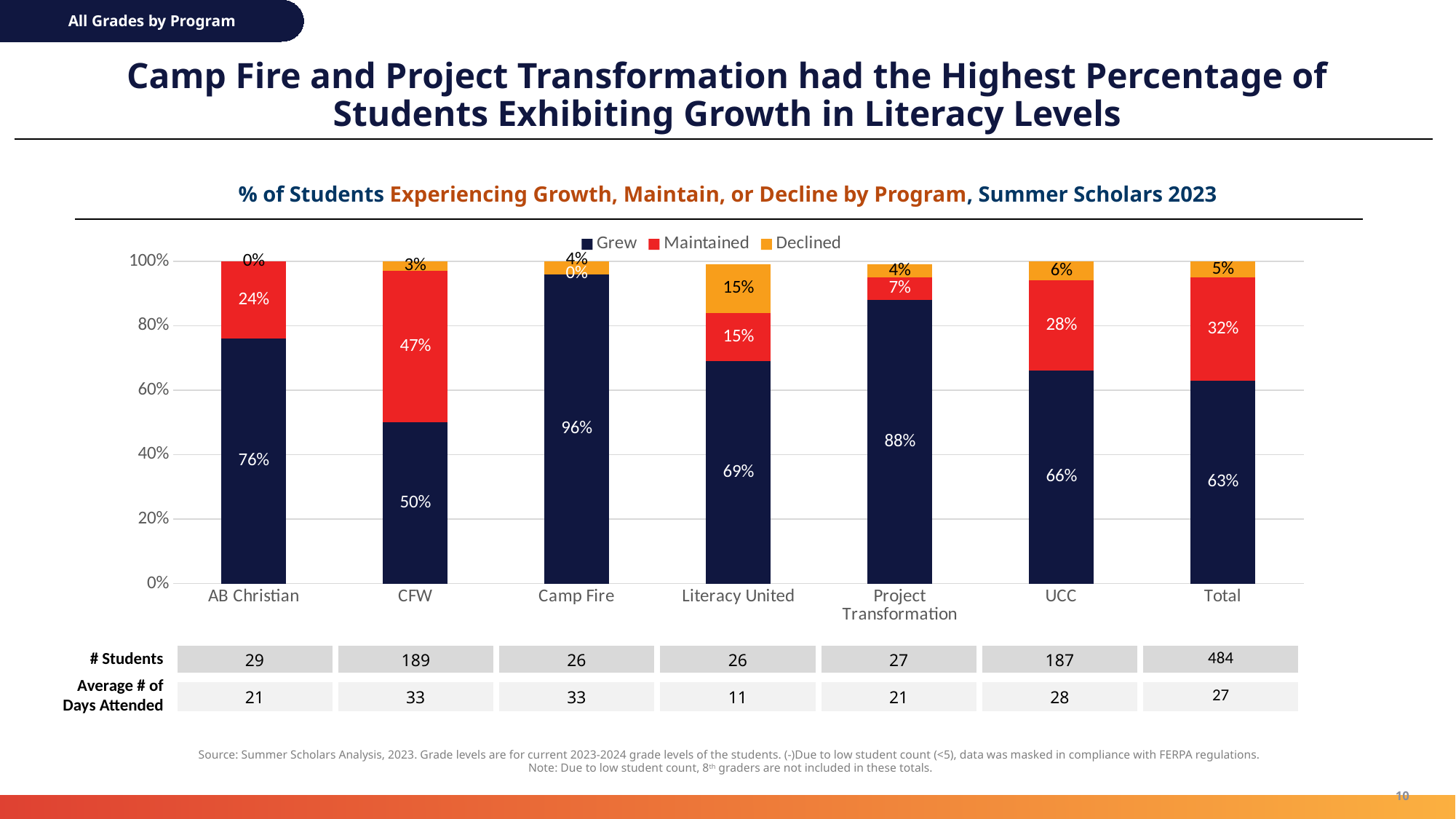
Which has a larger Maintained percentage, AB Christian or UCC? UCC How many program categories (including Total) are shown on the x axis? 7 What percentage of students at Camp Fire grew in literacy level? 96% What percentage of CFW students maintained their literacy level? 47% What is the Grew percentage for the Total bar? 63% Which series is shown in orange in the legend? Declined Which program has the highest percentage of students who grew? Camp Fire What is the difference between the Grew percentage for Project Transformation and for UCC? 22% What percentage of Literacy United students declined? 15% Which program has the lowest percentage of students who grew? CFW How many series does the legend list? 3 What kind of chart is shown on the slide? Stacked bar chart